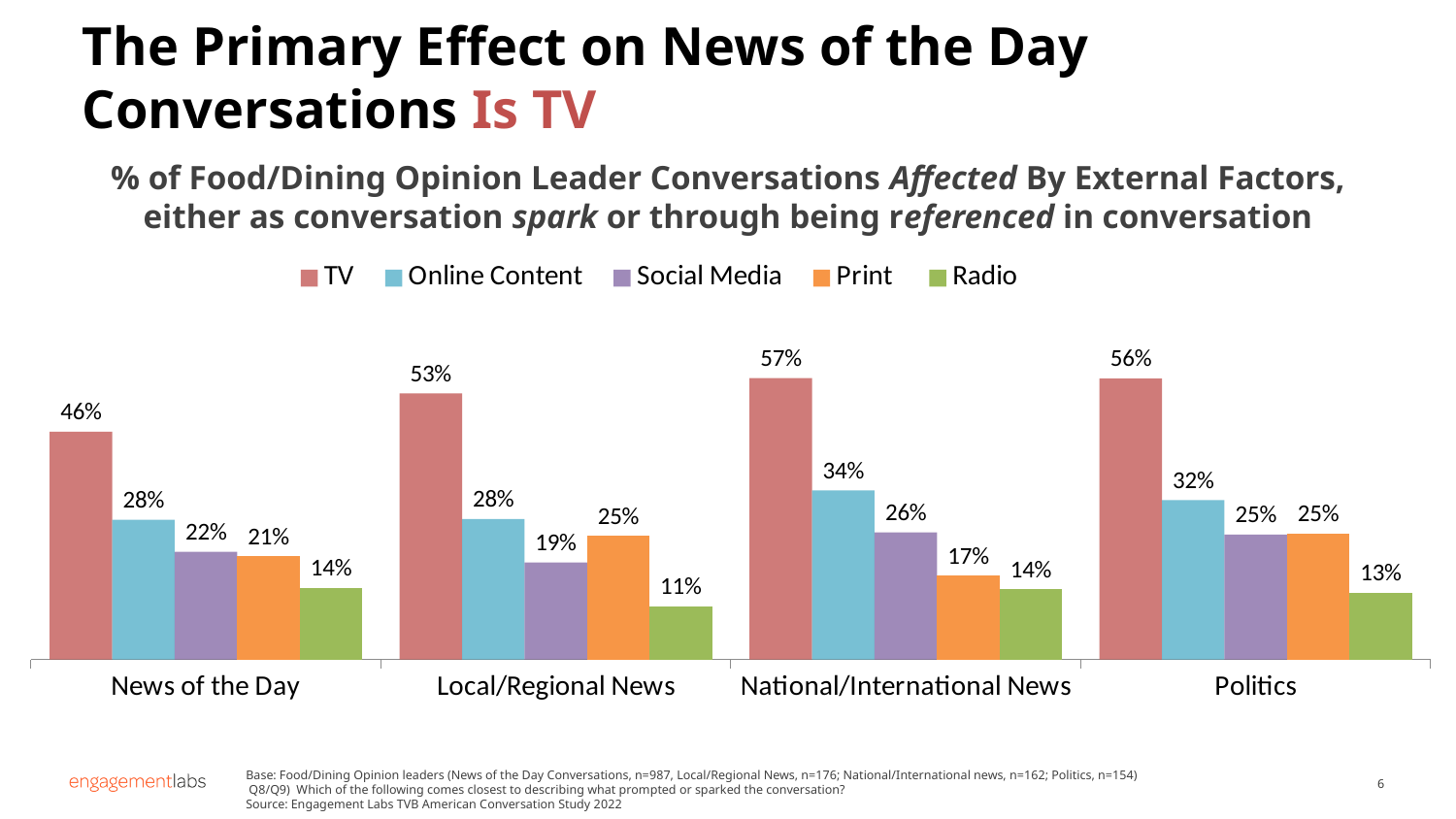
What kind of chart is shown on the slide? Bar chart What is the value for Print in the Local/Regional News category? 25% Which is larger in the Politics category: Online Content or Social Media? Online Content What is the value for TV in the News of the Day category? 46% What is the value for Radio in the Politics category? 13% How many series does the legend list? 5 How many categories are shown on the x axis? 4 Which series is shown in green in the legend? Radio What is the value for Social Media in the National/International News category? 26% Which category has the highest TV value? National/International News What is the difference between the TV and Online Content values in the National/International News category? 23% Which series has the lowest value in the Local/Regional News category? Radio